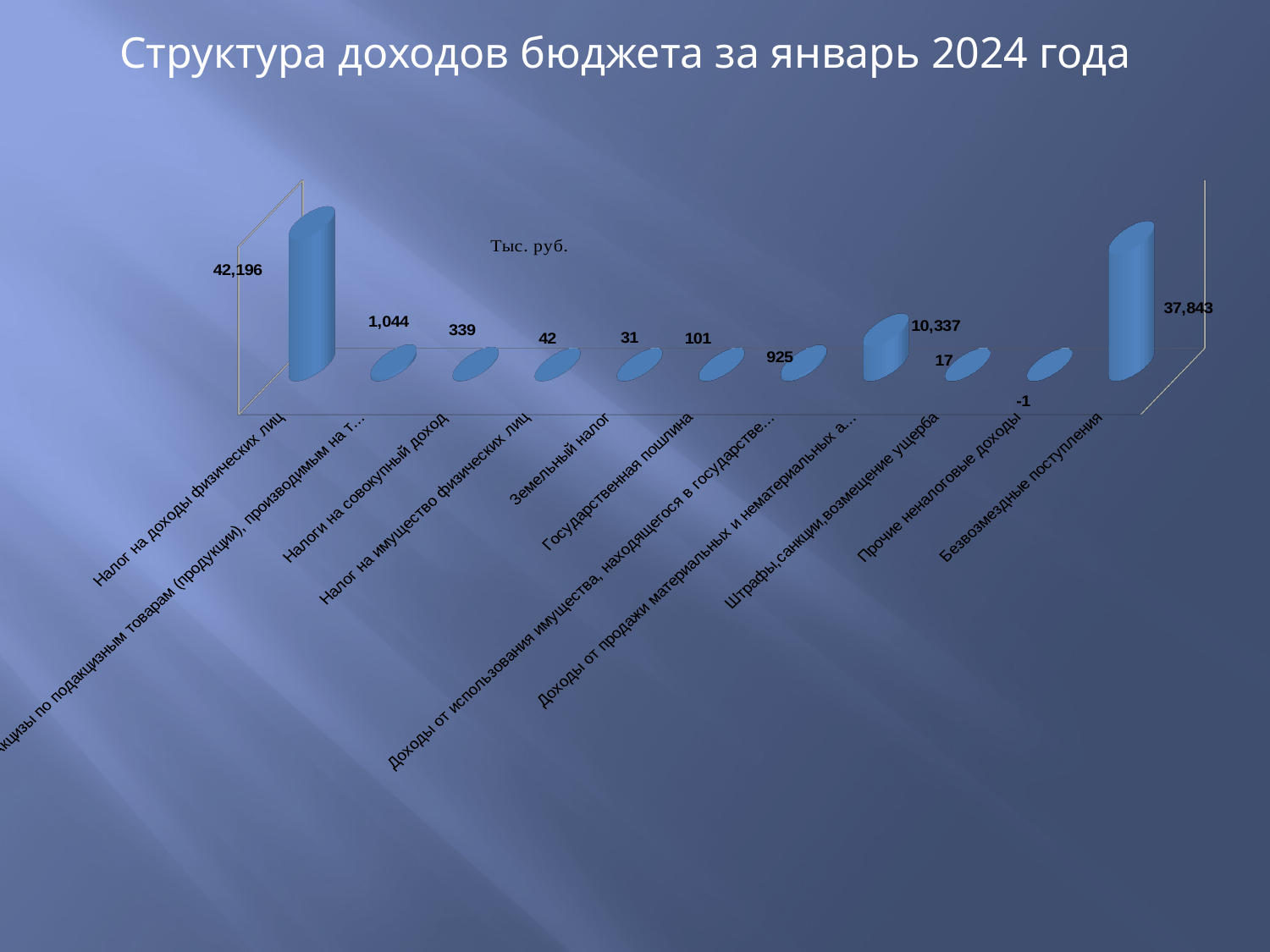
What is the value for Безвозмездные поступления? 37,843 How many categories are shown in the chart? 11 What is the value for Прочие неналоговые доходы? -1 Which is larger, the value for Государственная пошлина or the value for Налоги на совокупный доход? Налоги на совокупный доход Which category has the highest value? Налог на доходы физических лиц What is the value for Штрафы, санкции, возмещение ущерба? 17 What is the difference between the values for Налог на доходы физических лиц and Безвозмездные поступления? 4,353 What kind of chart is shown on the slide? Bar chart What unit is indicated on the chart? Тыс. руб. What is the value for Налог на доходы физических лиц? 42,196 Which category has the lowest value? Прочие неналоговые доходы What is the value for Земельный налог? 31